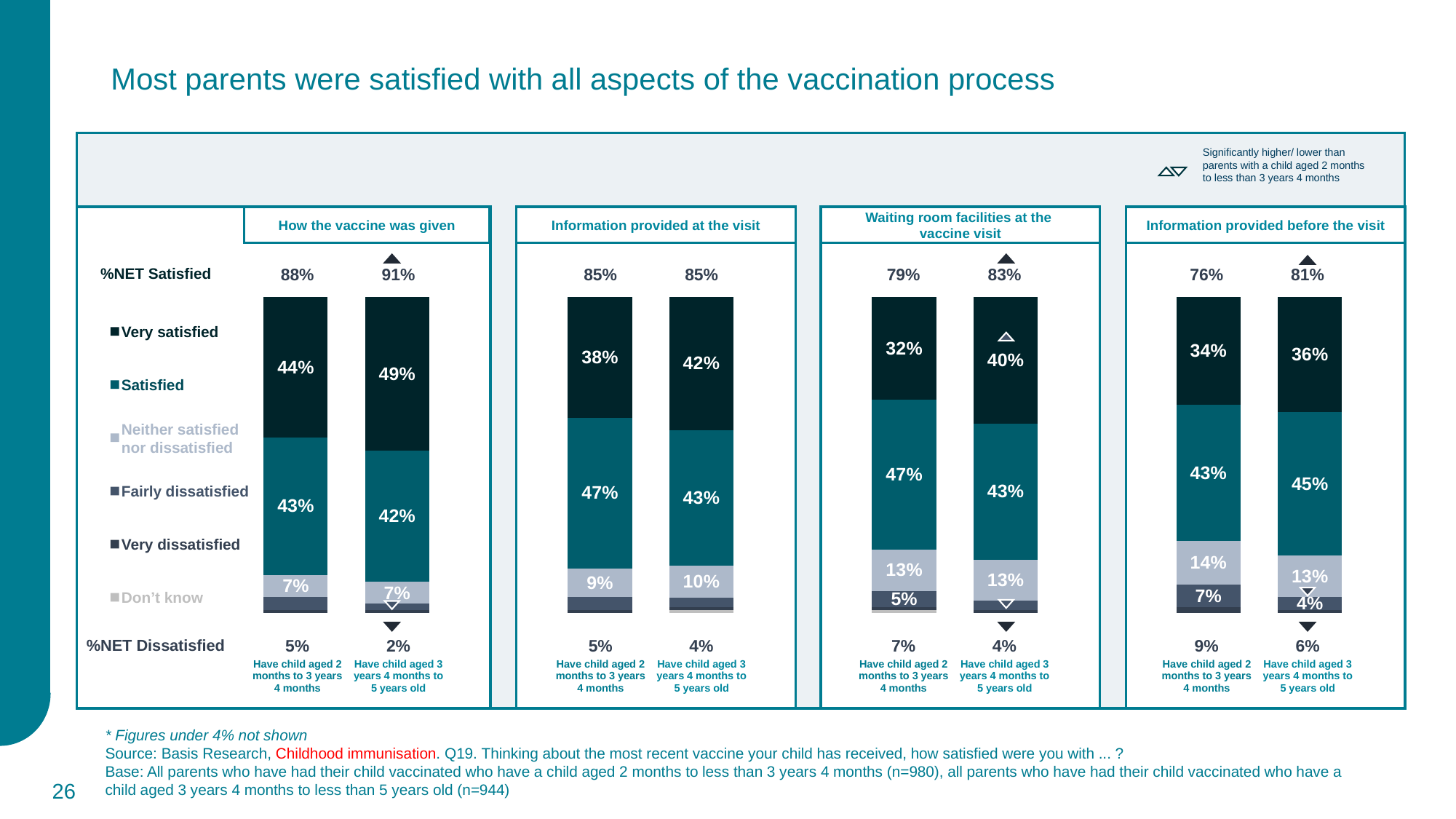
In the 'Information provided before the visit' chart, which age group has the higher %NET Satisfied? Have child aged 3 years 4 months to 5 years old How many bars are shown in the 'Information provided at the visit' chart? 2 In the 'Waiting room facilities at the vaccine visit' chart, what is the %NET Dissatisfied for parents with a child aged 2 months to 3 years 4 months? 7% In the 'How the vaccine was given' chart, what is the %NET Satisfied for parents who have a child aged 3 years 4 months to 5 years old? 91% What type of chart is used on this slide? Stacked bar chart How many series does the legend on the left of the slide list? 6 In the 'Information provided before the visit' chart, what percentage of parents with a child aged 2 months to 3 years 4 months were fairly dissatisfied? 7% In the 'Waiting room facilities at the vaccine visit' chart, what is the difference in the very satisfied percentage between the two age groups? 8% Across the four charts, which aspect has the lowest %NET Satisfied for parents with a child aged 2 months to 3 years 4 months? Information provided before the visit In the 'How the vaccine was given' chart, what percentage of parents with a child aged 2 months to 3 years 4 months were very satisfied? 44% Across the four charts, which aspect has the highest %NET Satisfied for parents with a child aged 3 years 4 months to 5 years old? How the vaccine was given In the 'Information provided at the visit' chart, what percentage of parents with a child aged 3 years 4 months to 5 years old were satisfied? 43%